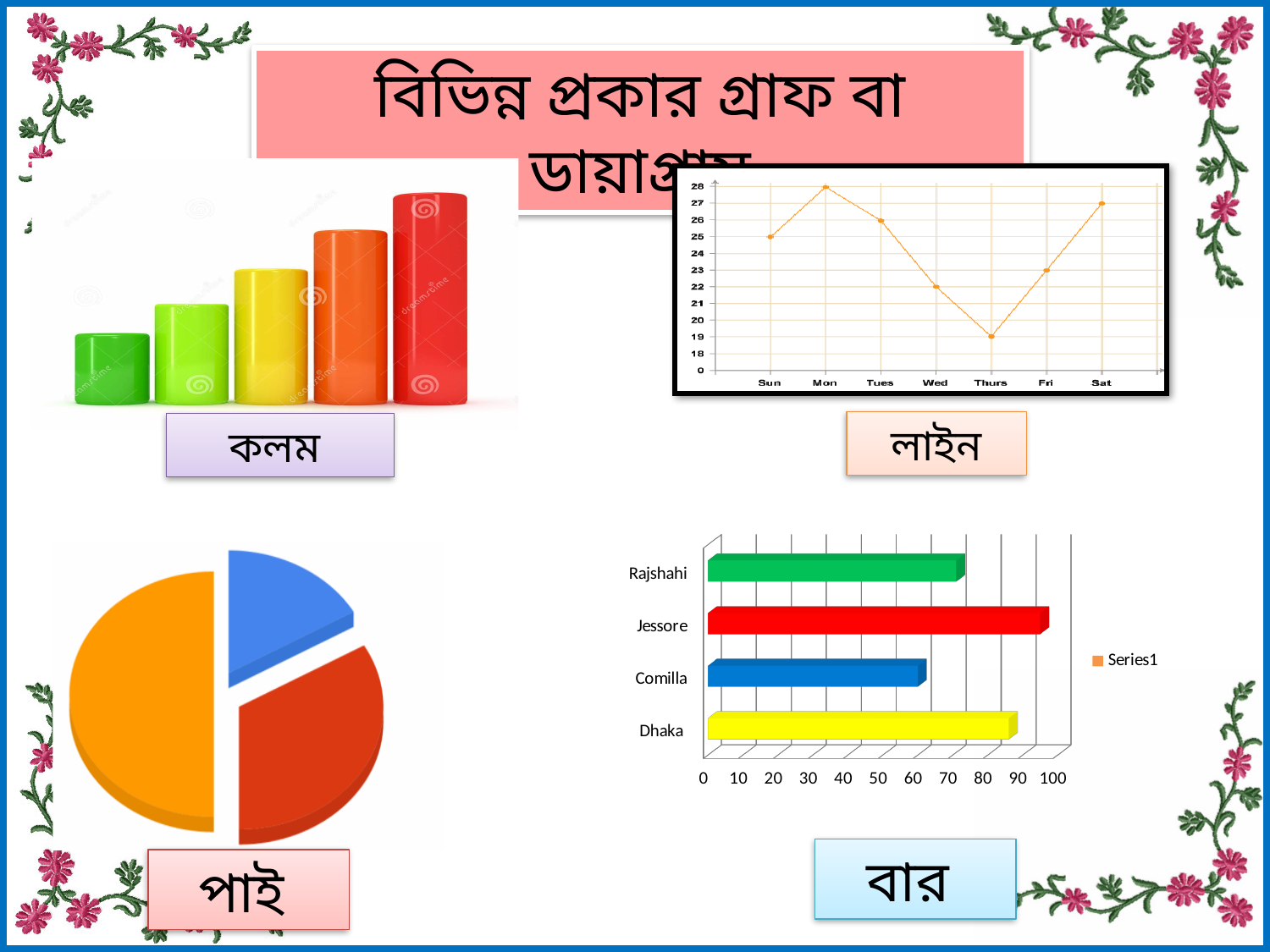
On the bar chart (bottom right), which category has the longest bar? Jessore What kind of chart is shown at the bottom left of the slide? Pie chart On the bar chart (bottom right), how many series does the legend list? 1 On the line chart (top right), which day has the lowest value? Thurs On the bar chart (bottom right), which category has the shortest bar? Comilla On the line chart (top right), how many days are plotted along the x axis? 7 On the line chart (top right), what is the value for Thurs? 19 On the bar chart (bottom right), which is larger, the value for Rajshahi or the value for Dhaka? Dhaka On the line chart (top right), which day has the highest value? Mon On the bar chart (bottom right), is the value for Dhaka greater or less than 80? greater On the line chart (top right), what is the value for Mon? 28 On the line chart (top right), what is the difference between the values for Sat and Wed? 5